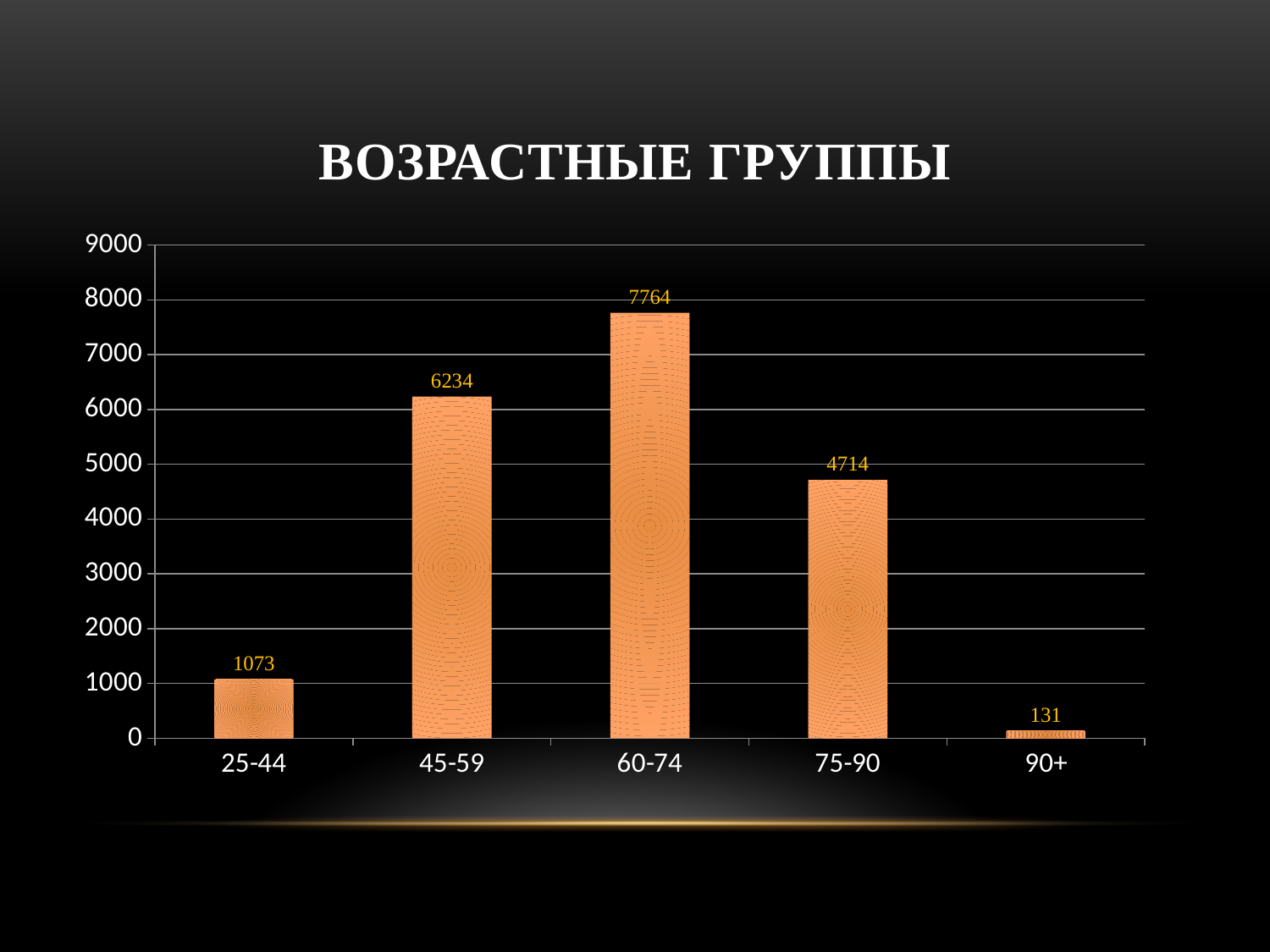
What is the difference between the values for 60-74 and 45-59? 1530 What is the difference between the values for 75-90 and 25-44? 3641 What kind of chart is shown on the slide? bar chart What is the value for the 60-74 age group? 7764 Which age group has the highest value? 60-74 Which is larger, the value for 45-59 or the value for 75-90? 45-59 What is the title of the chart? ВОЗРАСТНЫЕ ГРУППЫ What is the value for the 90+ age group? 131 What is the value for the 25-44 age group? 1073 Which age group has the lowest value? 90+ How many age groups are shown on the chart? 5 Is the value for 75-90 greater or less than 5000? less